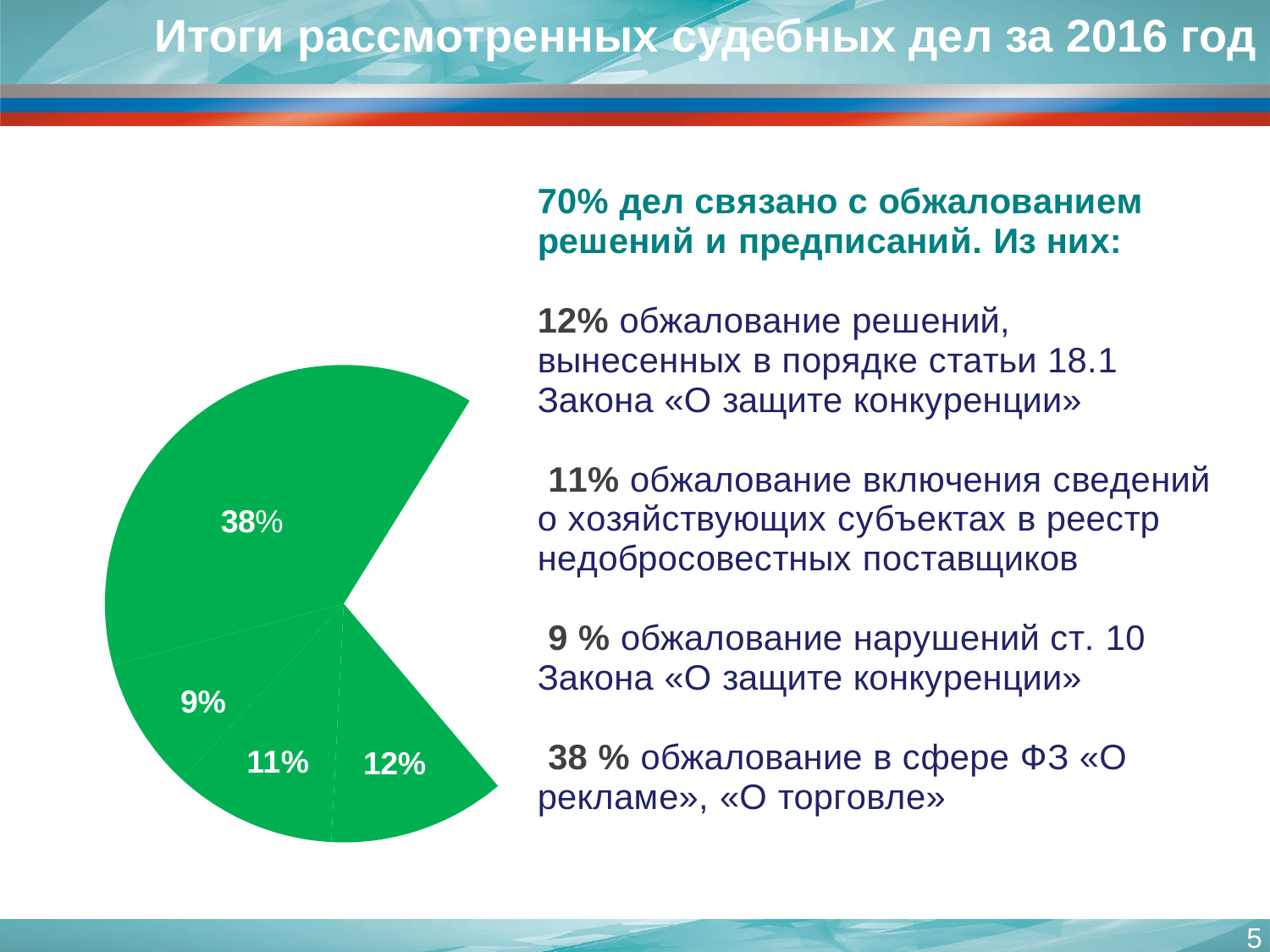
How many slices are shown in the pie chart? 4 What is the difference between the 38% slice and the 12% slice of the pie chart? 26% According to the slide, what share of cases concerns appeals of violations of article 10 of the Law «О защите конкуренции»? 9 % Which is larger on the pie chart: the slice for appeals under article 18.1 or the slice for appeals of violations of article 10? article 18.1 (12%) What kind of chart is shown on the slide? pie chart What is the largest value labelled on the pie chart? 38% What is the total of all the slices labelled on the pie chart? 70% According to the slide, what share of cases concerns appeals of decisions issued under article 18.1 of the Law «О защите конкуренции»? 12% What colour are the slices of the pie chart? green According to the slide, what share of cases concerns appeals in the sphere of the laws «О рекламе», «О торговле»? 38 % According to the slide, what share of cases concerns appeals of inclusion in the register of unscrupulous suppliers? 11% What is the smallest value labelled on the pie chart? 9%